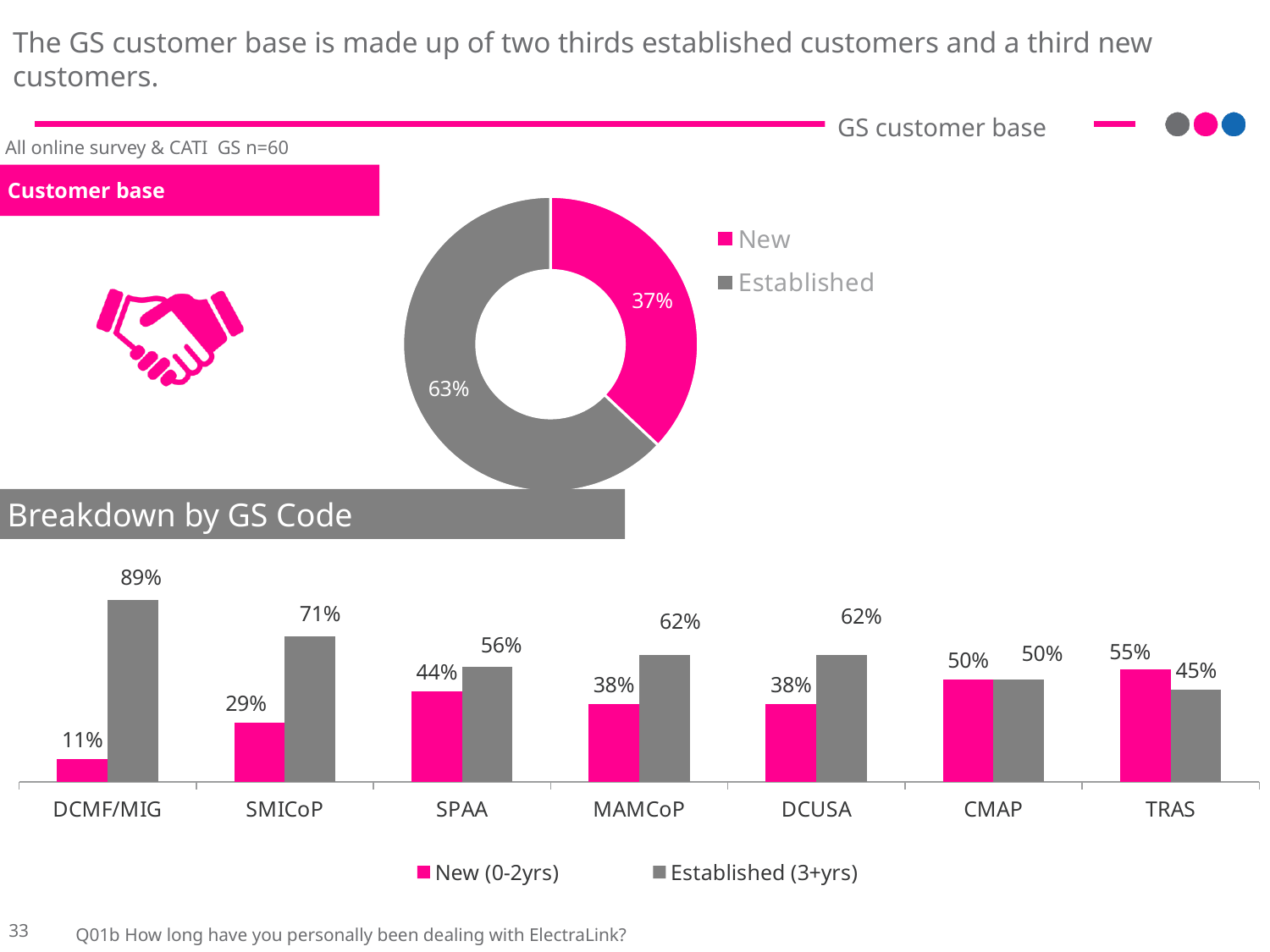
How many series does the legend of the Breakdown by GS Code bar chart list? 2 In the Breakdown by GS Code bar chart, what is the difference between the Established and New values for SPAA? 12 percentage points In the Breakdown by GS Code bar chart, what is the New (0-2yrs) value for SMICoP? 29% In the Customer base donut chart, what share of the GS customer base is Established? 63% In the Breakdown by GS Code bar chart, which GS code has the highest Established (3+yrs) value? DCMF/MIG In the Customer base donut chart, what share of the GS customer base is New? 37% In the Breakdown by GS Code bar chart, which is larger for TRAS: the New (0-2yrs) value or the Established (3+yrs) value? New (0-2yrs) How many GS codes are shown in the Breakdown by GS Code bar chart? 7 In the Breakdown by GS Code bar chart, what is the Established (3+yrs) value for DCMF/MIG? 89% What kind of chart is the Breakdown by GS Code chart? Bar chart What kind of chart is the Customer base chart at the top of the slide? Donut (pie) chart In the Breakdown by GS Code bar chart, which GS code has the lowest New (0-2yrs) value? DCMF/MIG